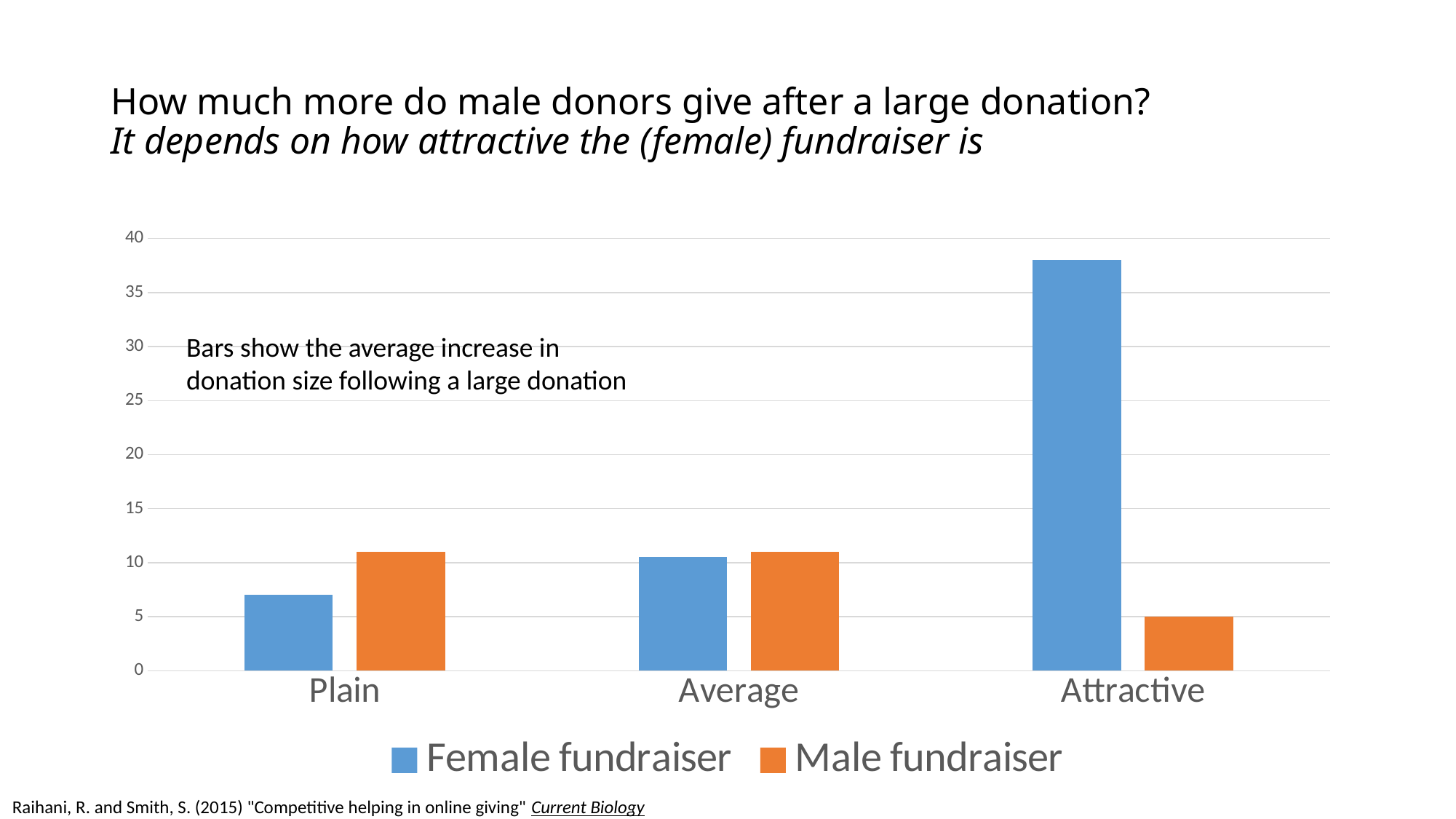
In the Plain category, which is larger: Female fundraiser or Male fundraiser? Male fundraiser What kind of chart is shown on the slide? bar chart How many categories are shown on the x axis? 3 Do the Female fundraiser values rise or fall from Plain to Attractive? rise What colour are the Male fundraiser bars? orange Which category has the highest value for Female fundraiser? Attractive How many series does the legend list? 2 Is the value for Female fundraiser in the Attractive category greater or less than 35? greater Which category has the lowest value for Female fundraiser? Plain Is the value for Female fundraiser in the Plain category greater or less than 10? less In the Attractive category, which is larger: Female fundraiser or Male fundraiser? Female fundraiser Which category has the lowest value for Male fundraiser? Attractive